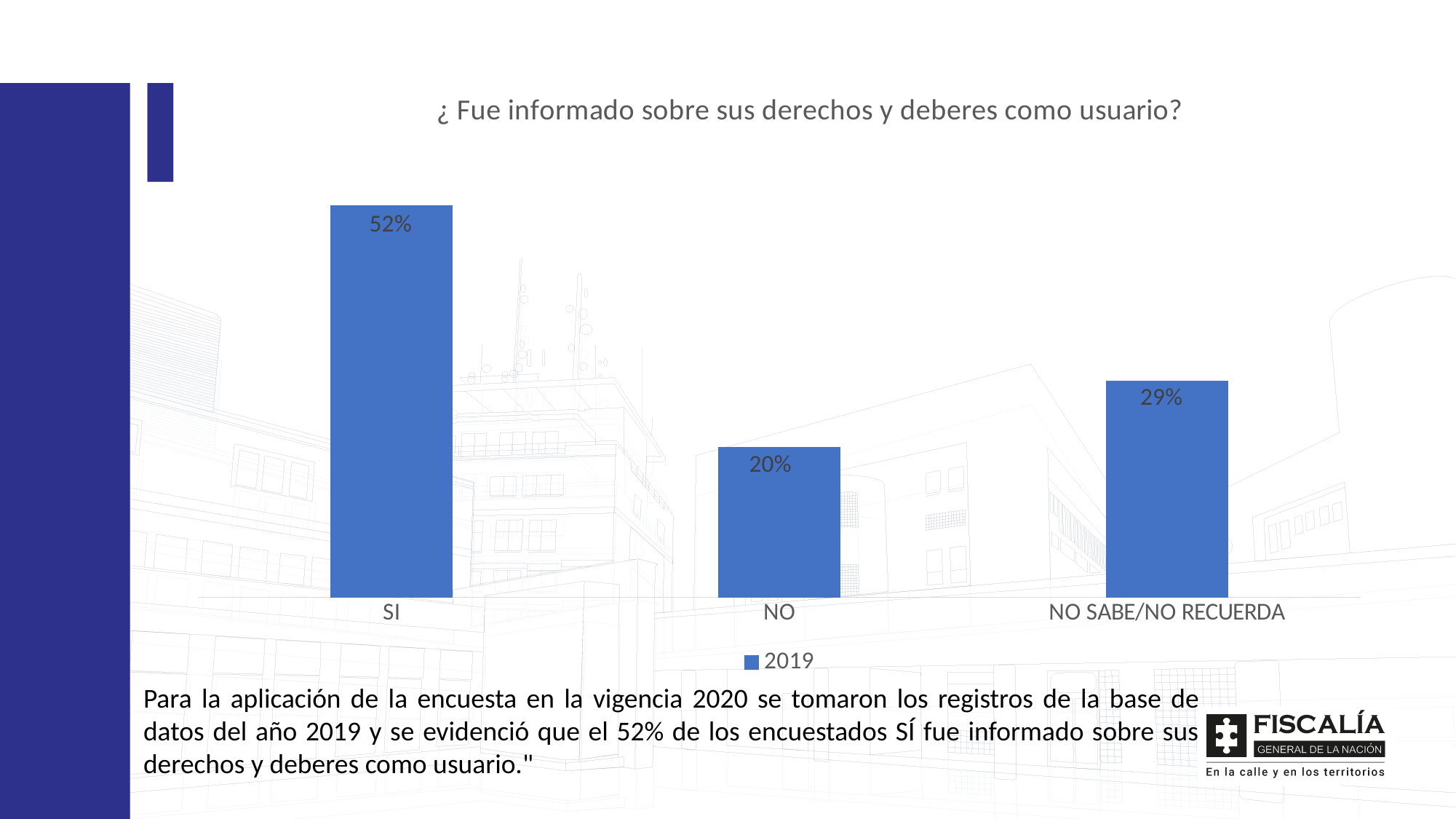
What kind of chart is shown? Bar chart What series name does the legend show? 2019 What is the difference between the values for NO SABE/NO RECUERDA and NO? 9% What is the value for SI? 52% How many series does the legend list? 1 What is the value for NO SABE/NO RECUERDA? 29% What is the difference between the values for SI and NO? 32% What is the value for NO? 20% Which category has the lowest value? NO Which category has the highest value? SI How many categories are shown on the x axis? 3 Which is larger, the value for NO or the value for NO SABE/NO RECUERDA? NO SABE/NO RECUERDA